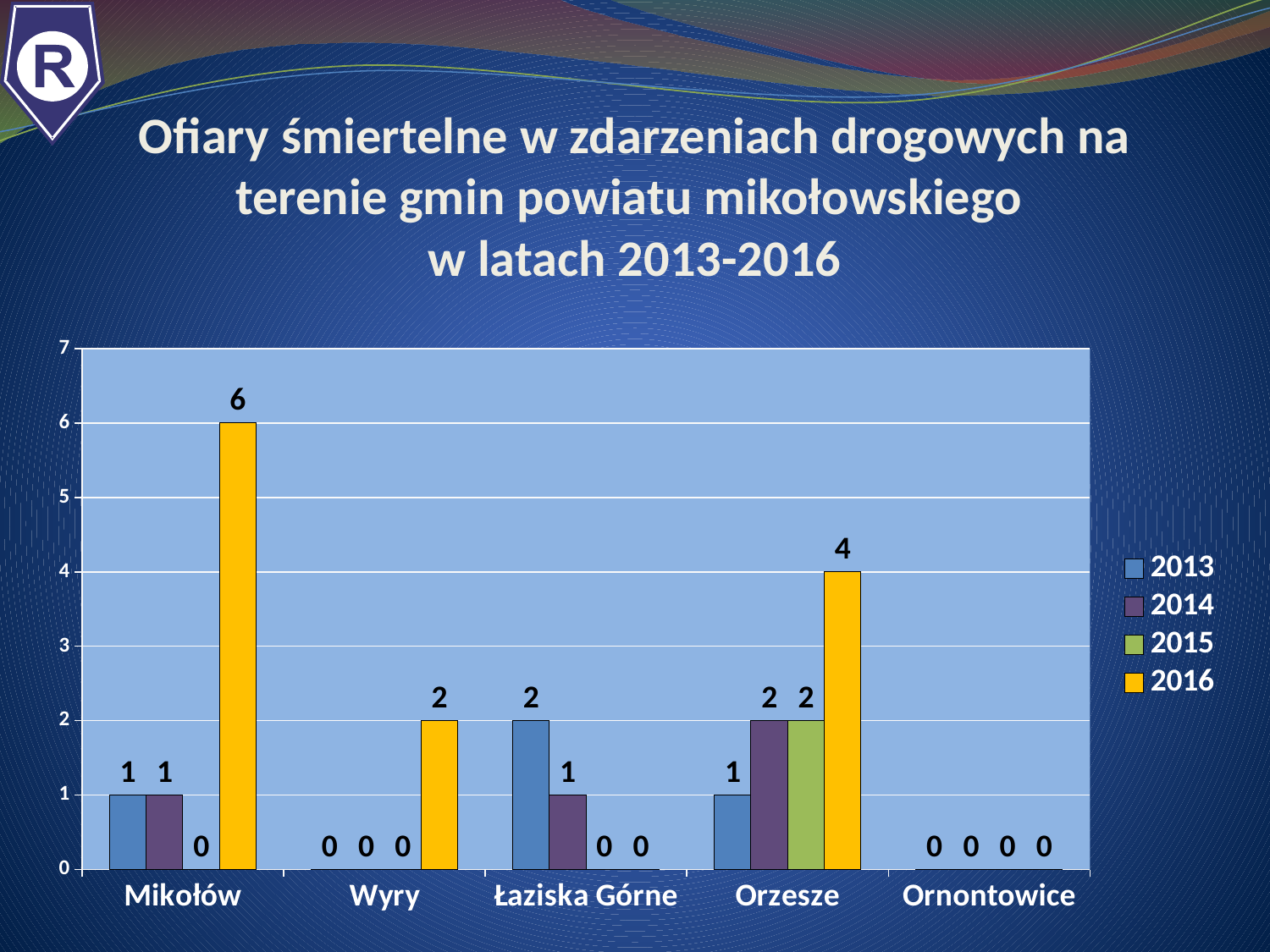
Which category has the highest value in the 2016 series? Mikołów Which category has the highest value in the 2013 series? Łaziska Górne What is the value for Łaziska Górne in 2013? 2 What is the value for Orzesze in 2014? 2 Which colour represents the 2016 series in the legend? Yellow What is the value for Mikołów in 2016? 6 What is the value for Wyry in 2016? 2 How many categories are shown on the x axis? 5 Which is larger: the 2016 value for Orzesze or the 2016 value for Wyry? Orzesze What is the difference between the 2016 values for Mikołów and Orzesze? 2 What kind of chart is shown on the slide? Bar chart How many series does the legend list? 4